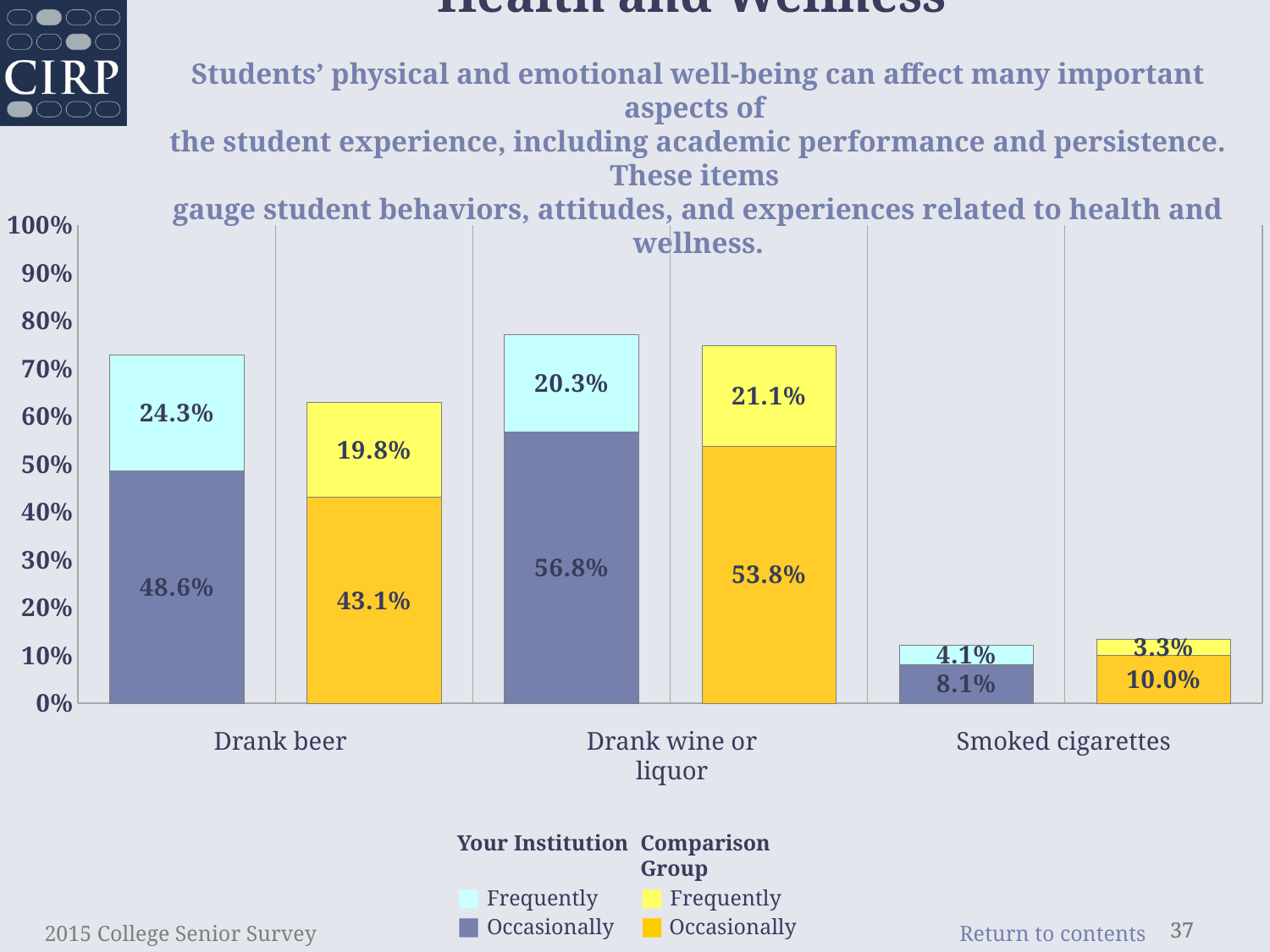
What is the total percentage of Your Institution students who drank beer (frequently plus occasionally)? 72.9% What is the total percentage of the Comparison Group who drank wine or liquor (frequently plus occasionally)? 74.9% Which category has the highest total for the Comparison Group? Drank wine or liquor How many series does the legend list? 4 Which is larger: the Comparison Group's occasionally smoked cigarettes value or Your Institution's occasionally smoked cigarettes value? Comparison Group Which category has the lowest total for Your Institution? Smoked cigarettes What is the difference between Your Institution and the Comparison Group for occasionally drinking beer? 5.5% What kind of chart is shown on the slide? Stacked bar chart What percentage of students at Your Institution reported occasionally drinking beer? 48.6% What percentage of students at Your Institution reported frequently smoking cigarettes? 4.1% How many categories are shown on the x axis? 3 What percentage of the Comparison Group reported frequently drinking wine or liquor? 21.1%